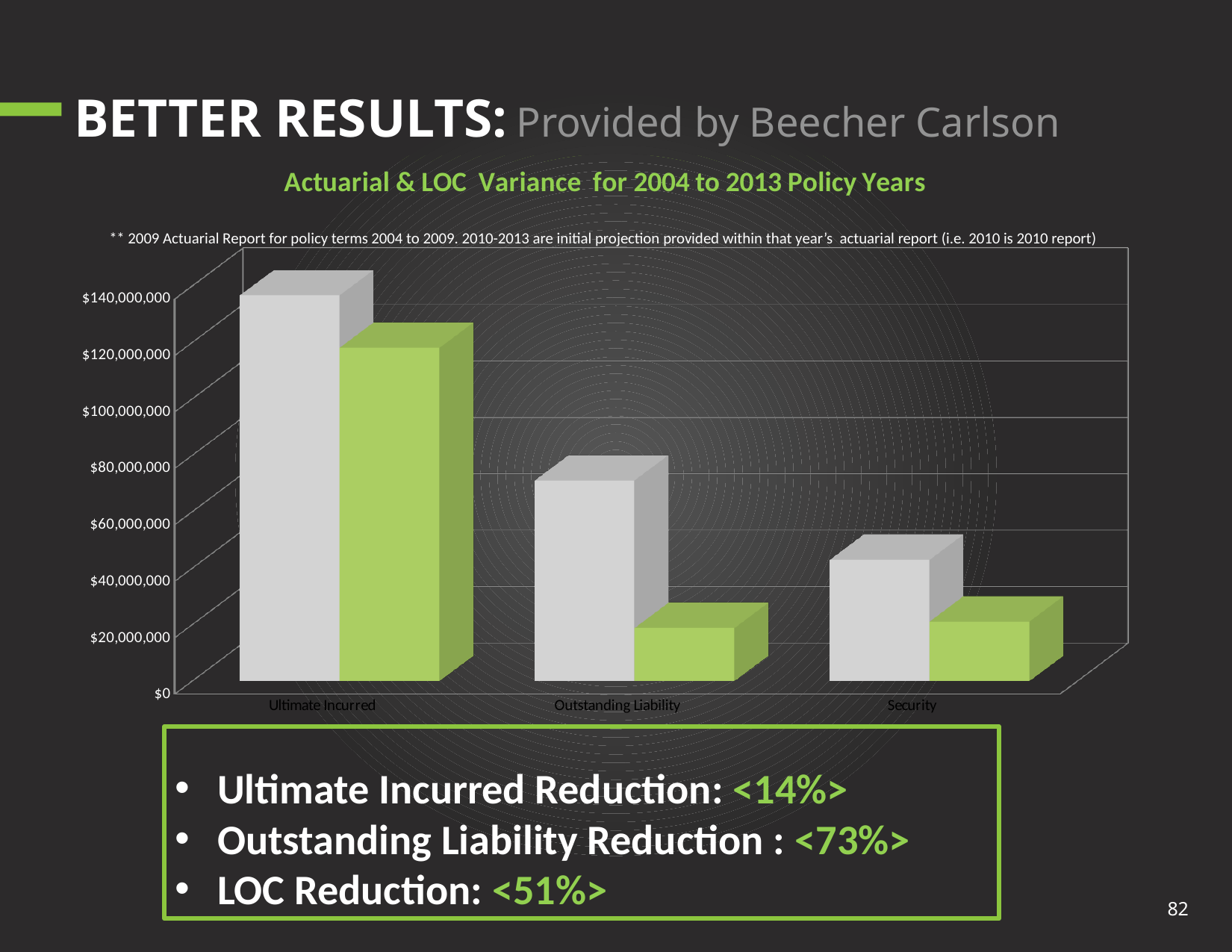
Is the grey bar for Ultimate Incurred greater or less than $100,000,000? greater How many categories are shown on the x axis of the chart? 3 What two colours are used for the bars in the chart? grey and green What is the title of the chart? Actuarial & LOC Variance for 2004 to 2013 Policy Years What kind of chart is shown on the slide? bar chart Is the green bar for Outstanding Liability greater or less than $40,000,000? less Which category has the tallest bars in the chart? Ultimate Incurred Do the grey bars rise or fall moving from Ultimate Incurred to Security along the x axis? fall Among the grey bars, which category has the lowest value? Security For Outstanding Liability, which bar is larger, the grey bar or the green bar? the grey bar Is the green bar for Ultimate Incurred greater or less than $100,000,000? greater